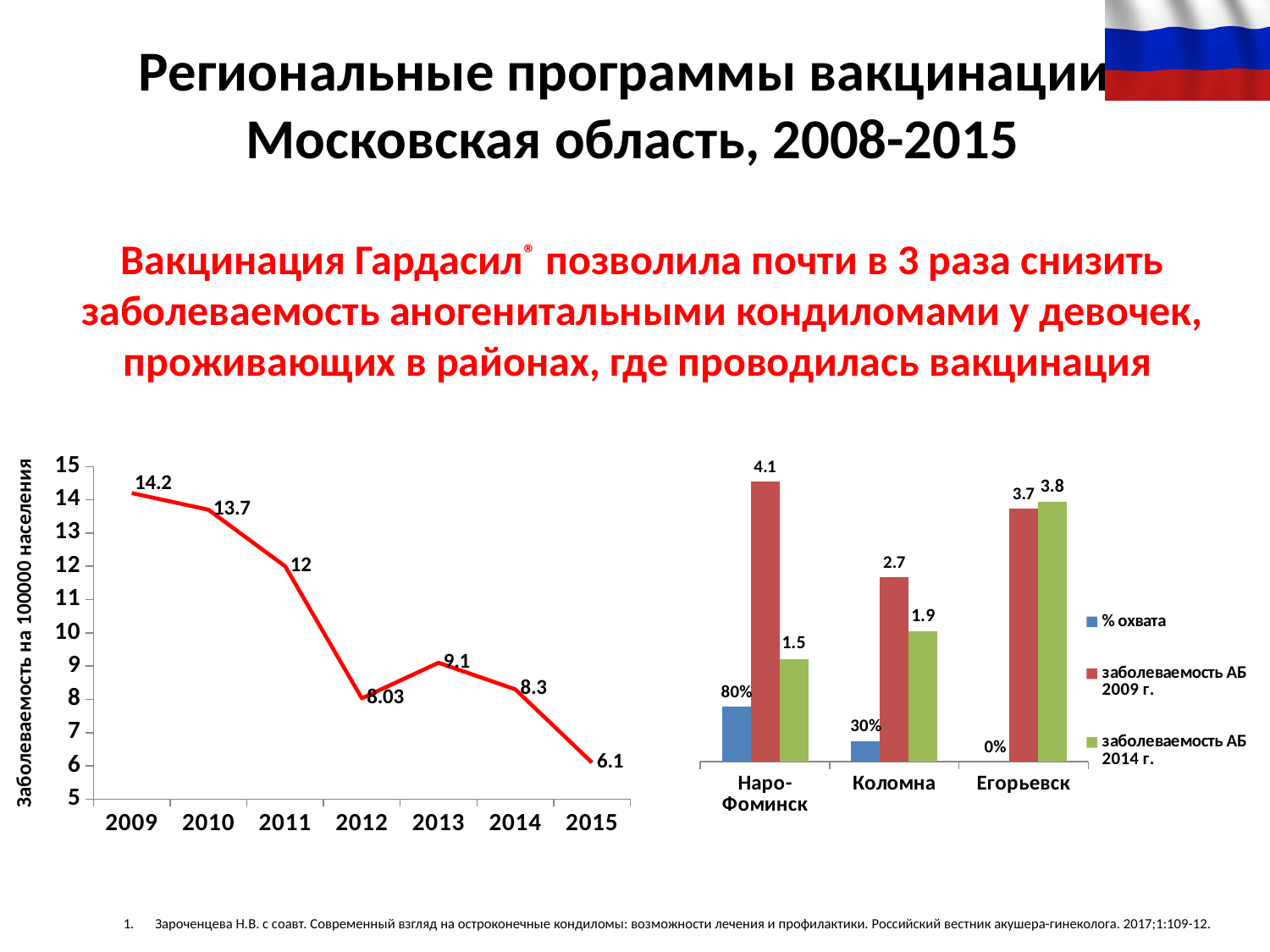
In the bar chart on the right, which is larger for Коломна: заболеваемость АБ 2009 г. or заболеваемость АБ 2014 г.? заболеваемость АБ 2009 г. In the line chart on the left, how many years are plotted on the x axis? 7 In the bar chart on the right, how many series does the legend list? 3 In the bar chart on the right, what is the % охвата for Коломна? 30% What kind of chart is shown on the right side of the slide? bar chart In the line chart on the left, which year has the highest value? 2009 In the line chart on the left, which year has the lowest value? 2015 In the line chart on the left, what is the difference between the values for 2009 and 2015? 8.1 In the line chart on the left, do the values generally rise or fall from 2009 to 2015? fall In the line chart on the left, what is the value for 2012? 8.03 In the line chart on the left, what is the value for 2009? 14.2 In the bar chart on the right, what is the value of заболеваемость АБ 2009 г. for Наро-Фоминск? 4.1